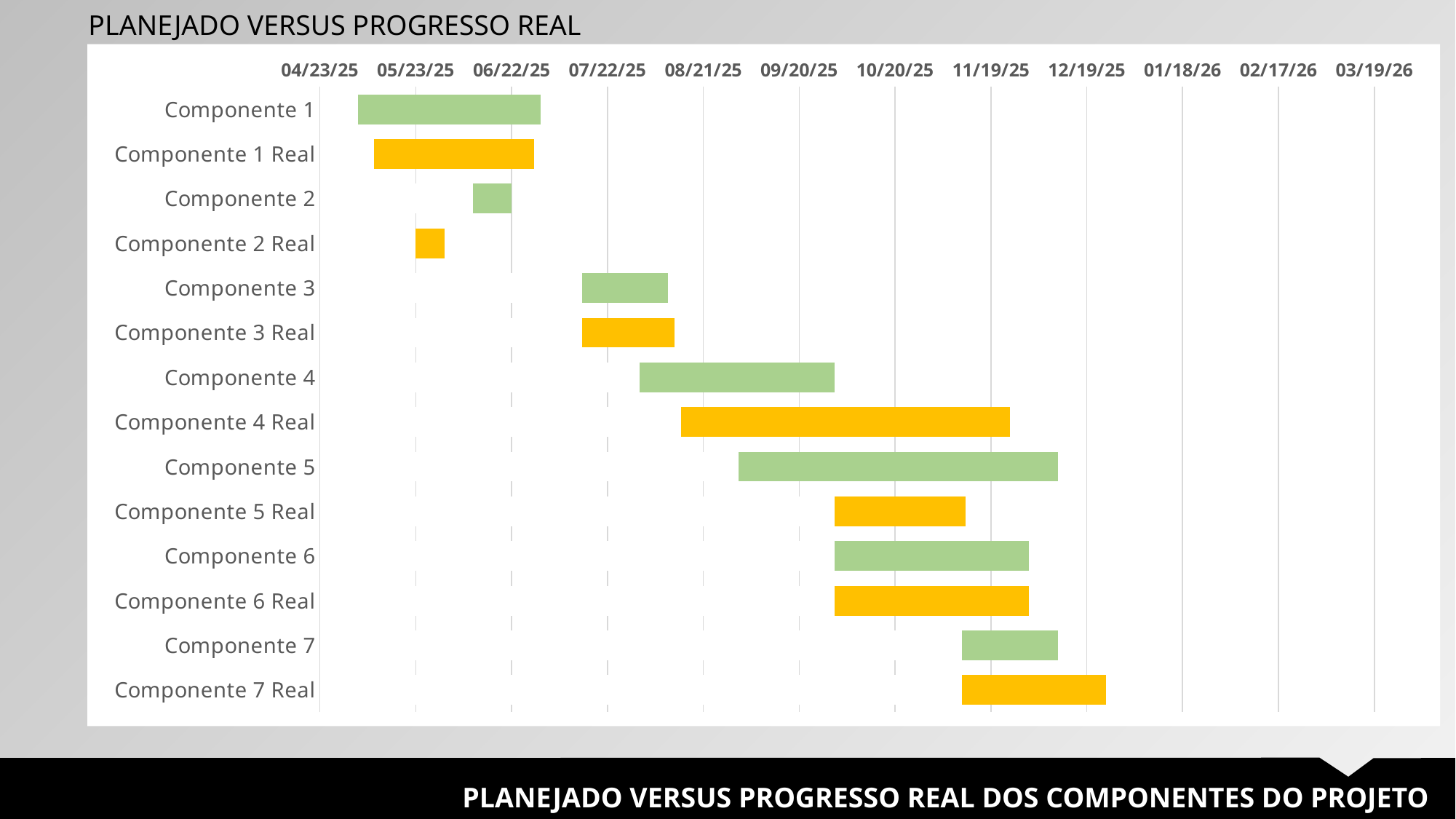
Which row has the shortest bar in the chart? Componente 2 Real Does the bar for Componente 7 Real end before or after 12/19/25? after Which row has the longest bar in the chart? Componente 4 Real Does the bar for Componente 6 end before or after 12/19/25? before What is the title of the chart? PLANEJADO VERSUS PROGRESSO REAL What colour are the bars for the 'Real' rows in the chart? yellow How many categories (rows) are listed on the vertical axis of the chart? 14 Which row's bar starts earliest on the date axis? Componente 1 Which bar is longer, Componente 1 or Componente 2? Componente 1 What kind of chart is shown on the slide? bar chart Does the bar for Componente 5 Real start before or after 09/20/25? after Which bar is longer, Componente 5 or Componente 5 Real? Componente 5